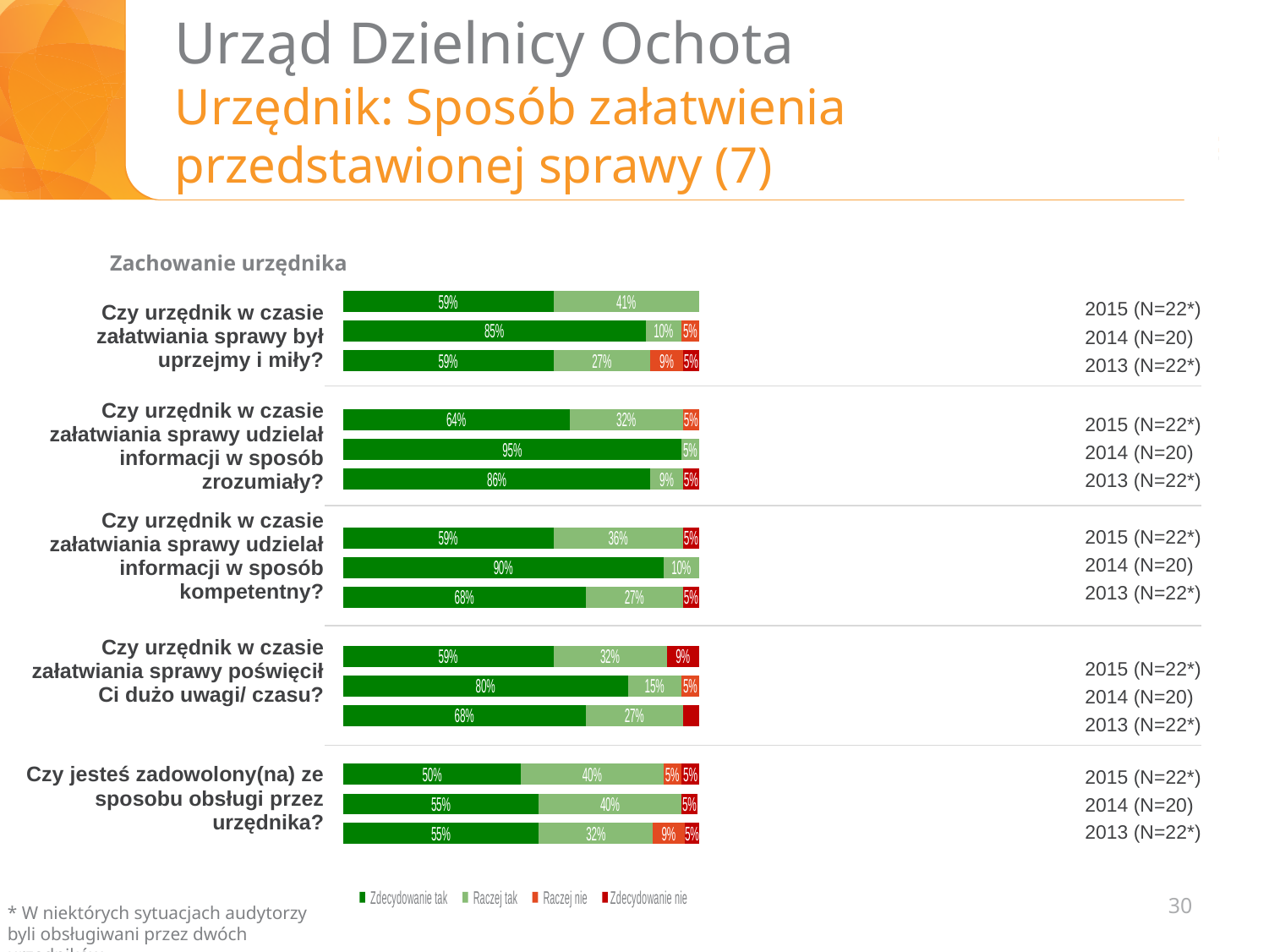
Which year has the highest 'Zdecydowanie tak' value for the question 'Czy urzędnik w czasie załatwiania sprawy udzielał informacji w sposób kompetentny?'? 2014 Which year has the lowest 'Zdecydowanie tak' value for the question 'Czy jesteś zadowolony(na) ze sposobu obsługi przez urzędnika?'? 2015 What is the 'Zdecydowanie tak' value for 2014 for the question 'Czy urzędnik w czasie załatwiania sprawy udzielał informacji w sposób zrozumiały?'? 95% For the question 'Czy urzędnik w czasie załatwiania sprawy był uprzejmy i miły?', what is the difference between the 'Zdecydowanie tak' values for 2014 and 2015? 26 percentage points How many survey questions are shown in the chart? 5 What is the sample size (N) shown for 2014? N=20 What is the 'Zdecydowanie tak' value for 2013 for the question 'Czy urzędnik w czasie załatwiania sprawy poświęcił Ci dużo uwagi/ czasu?'? 68% For the question 'Czy urzędnik w czasie załatwiania sprawy udzielał informacji w sposób zrozumiały?', is the 'Zdecydowanie tak' value larger in 2013 or 2015? 2013 How many series does the legend list? 4 What is the 'Raczej tak' value for 2015 for the question 'Czy jesteś zadowolony(na) ze sposobu obsługi przez urzędnika?'? 40% What kind of chart is shown on the slide? Stacked bar chart What is the 'Zdecydowanie tak' value for 2015 for the question 'Czy urzędnik w czasie załatwiania sprawy był uprzejmy i miły?'? 59%